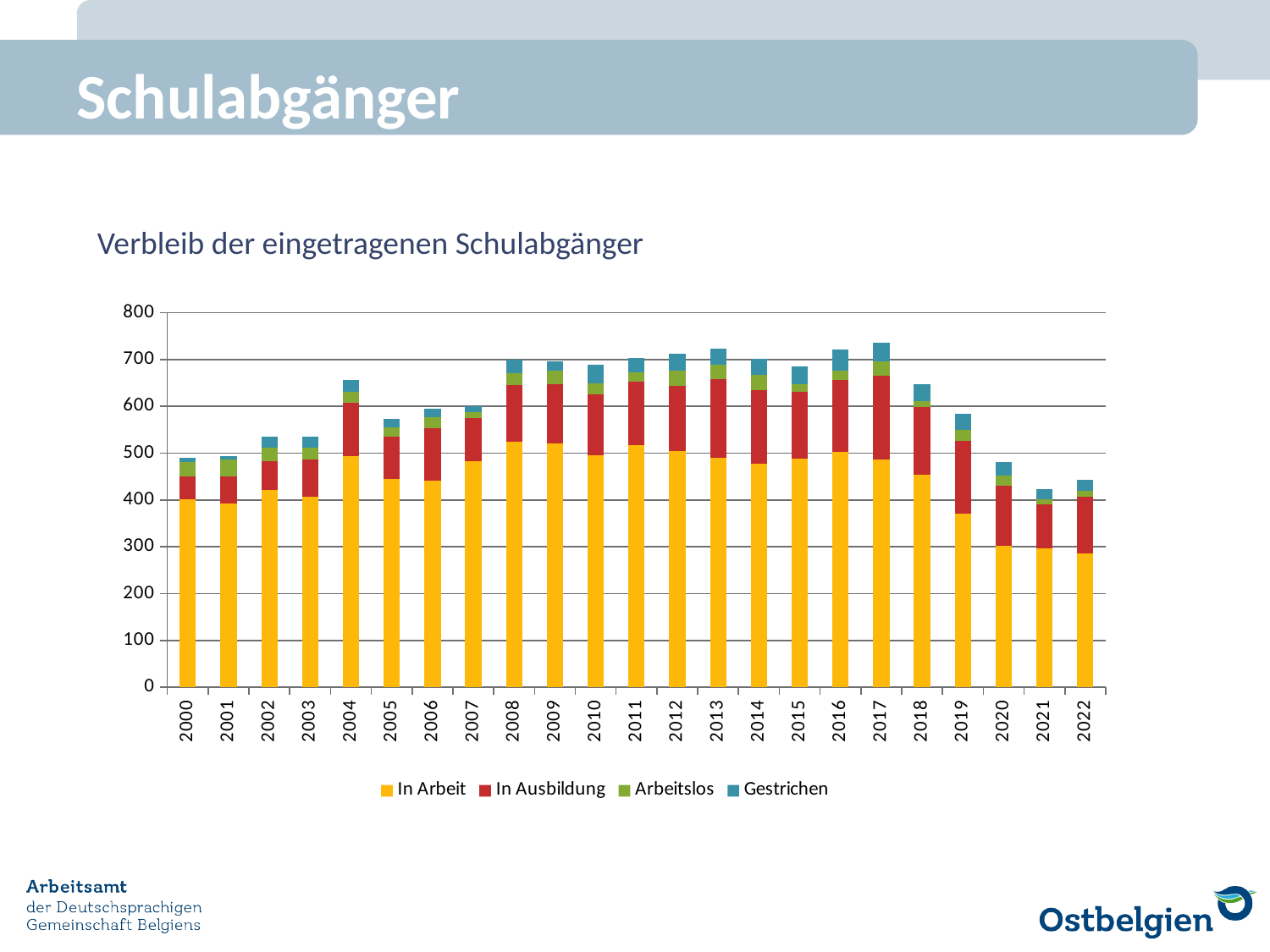
Which year has the highest total stacked bar? 2017 Is the total stacked value for 2004 greater or less than 600? greater What is the title of the chart? Verbleib der eingetragenen Schulabgänger Which legend entry is shown in yellow? In Arbeit Is the 'In Arbeit' value for 2019 greater or less than 400? less Is the total stacked value for 2021 greater or less than 500? less How many series does the legend list? 4 How many years are shown on the x axis? 23 Which year has the larger total stacked bar, 2000 or 2008? 2008 What kind of chart is shown on the slide? stacked bar chart